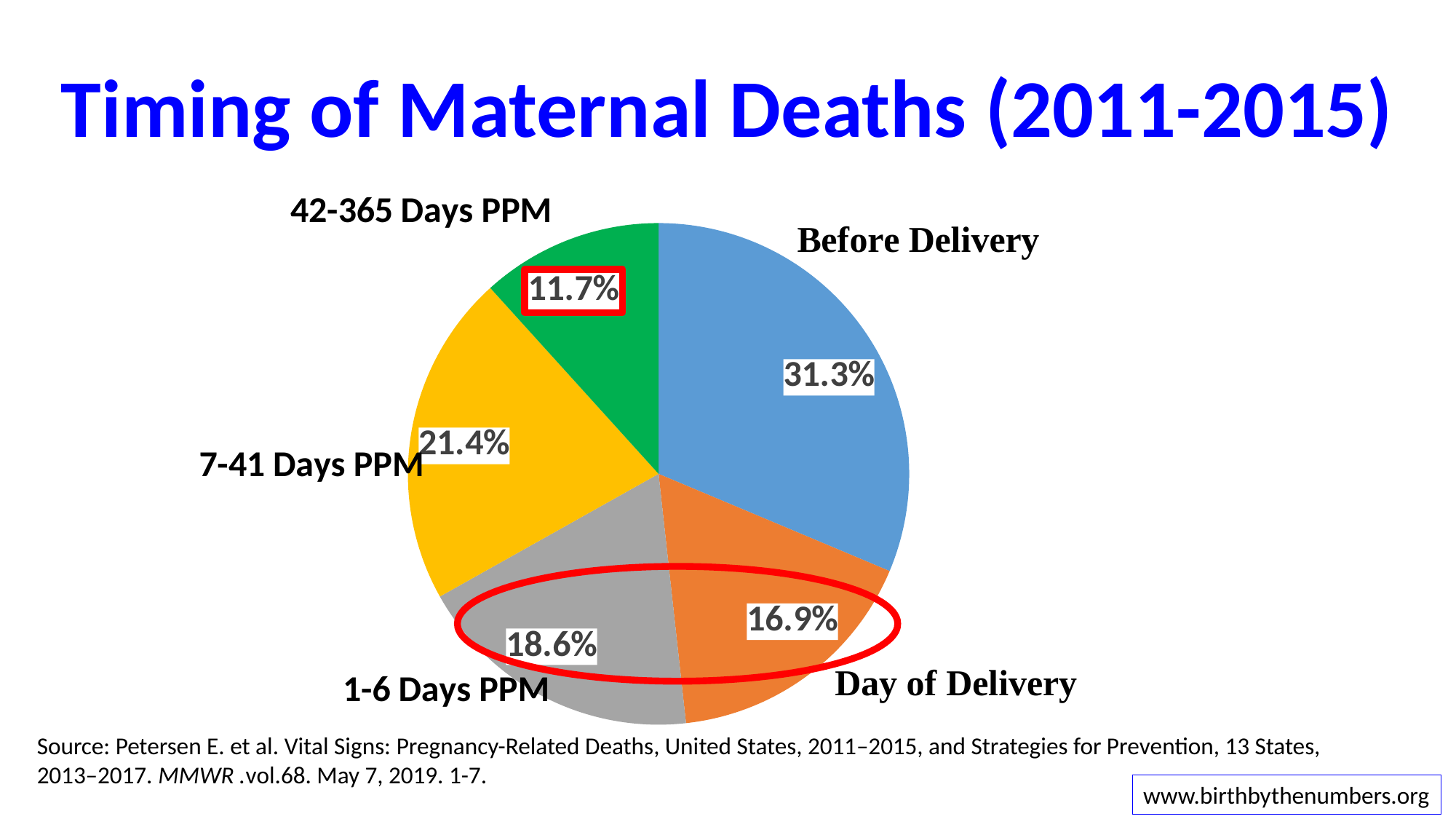
What kind of chart is shown on the slide? pie chart How many slices does the pie chart have? 5 Which timing category has the smallest share of maternal deaths? 42-365 Days PPM What share of maternal deaths occurred on the day of delivery? 16.9% Which is larger, the share for 1-6 Days PPM or the share for Day of Delivery? 1-6 Days PPM What is the difference in percentage points between the Before Delivery slice and the Day of Delivery slice? 14.4 What share of maternal deaths occurred 7-41 days PPM? 21.4% What is the title of the chart? Timing of Maternal Deaths (2011-2015) What share of maternal deaths occurred 1-6 days PPM? 18.6% Which timing category has the largest share of maternal deaths? Before Delivery What share of maternal deaths occurred before delivery? 31.3% What share of maternal deaths occurred 42-365 days PPM? 11.7%